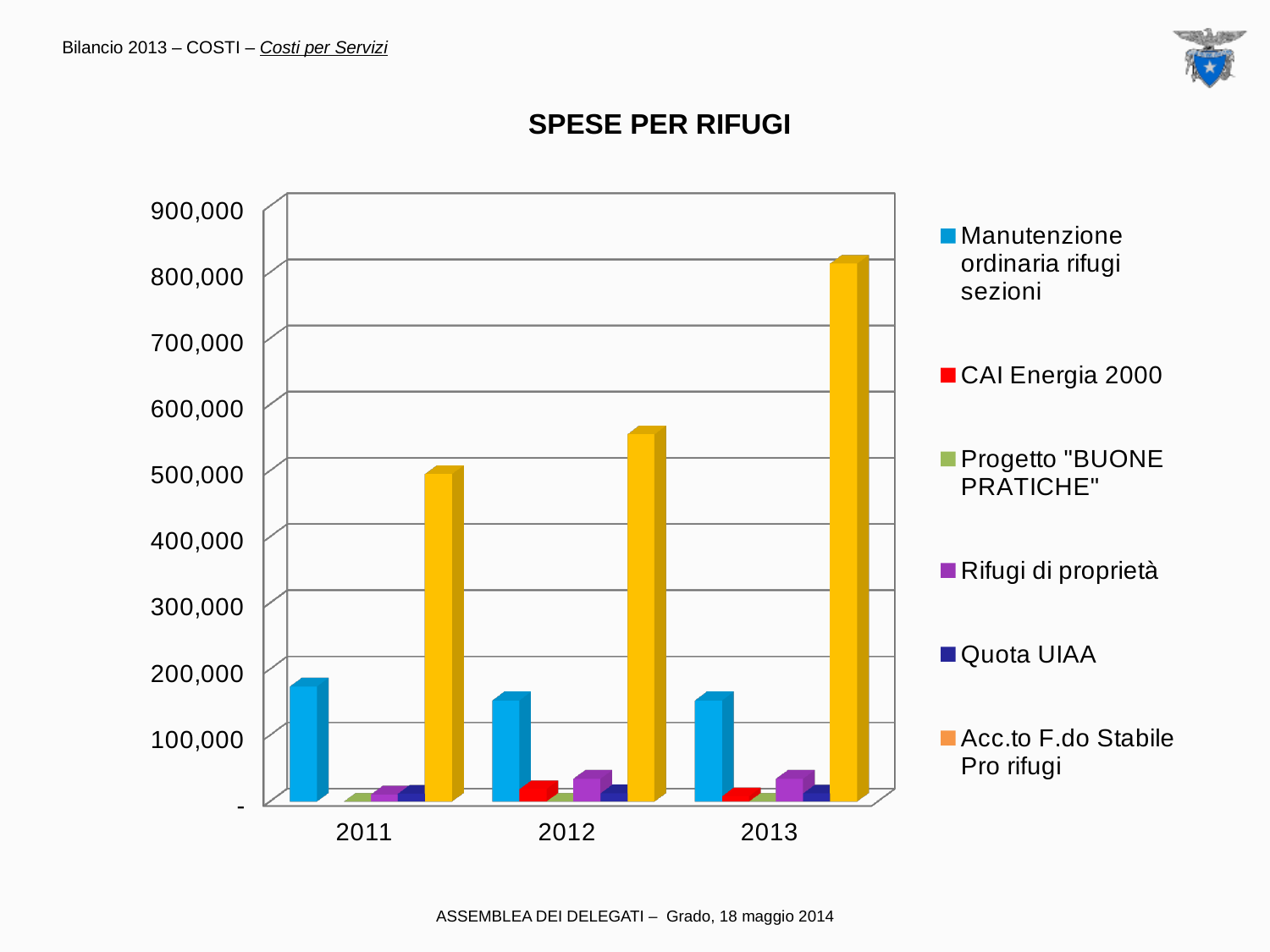
In which year is the value for Acc.to F.do Stabile Pro rifugi highest? 2013 Is the value for Acc.to F.do Stabile Pro rifugi in 2012 greater or less than 500,000? greater How many series does the chart's legend list? 6 In which year is the value for Acc.to F.do Stabile Pro rifugi lowest? 2011 Is the value for Acc.to F.do Stabile Pro rifugi in 2013 greater or less than 700,000? greater What kind of chart is shown on the slide? bar chart Which series has the highest value in 2012? Acc.to F.do Stabile Pro rifugi Does the value for Acc.to F.do Stabile Pro rifugi rise or fall from 2011 to 2013? rise In 2013, which is larger: Acc.to F.do Stabile Pro rifugi or Manutenzione ordinaria rifugi sezioni? Acc.to F.do Stabile Pro rifugi Is the value for Manutenzione ordinaria rifugi sezioni in 2011 greater or less than 200,000? less How many years are shown on the x axis of the chart? 3 What is the title of the chart? SPESE PER RIFUGI